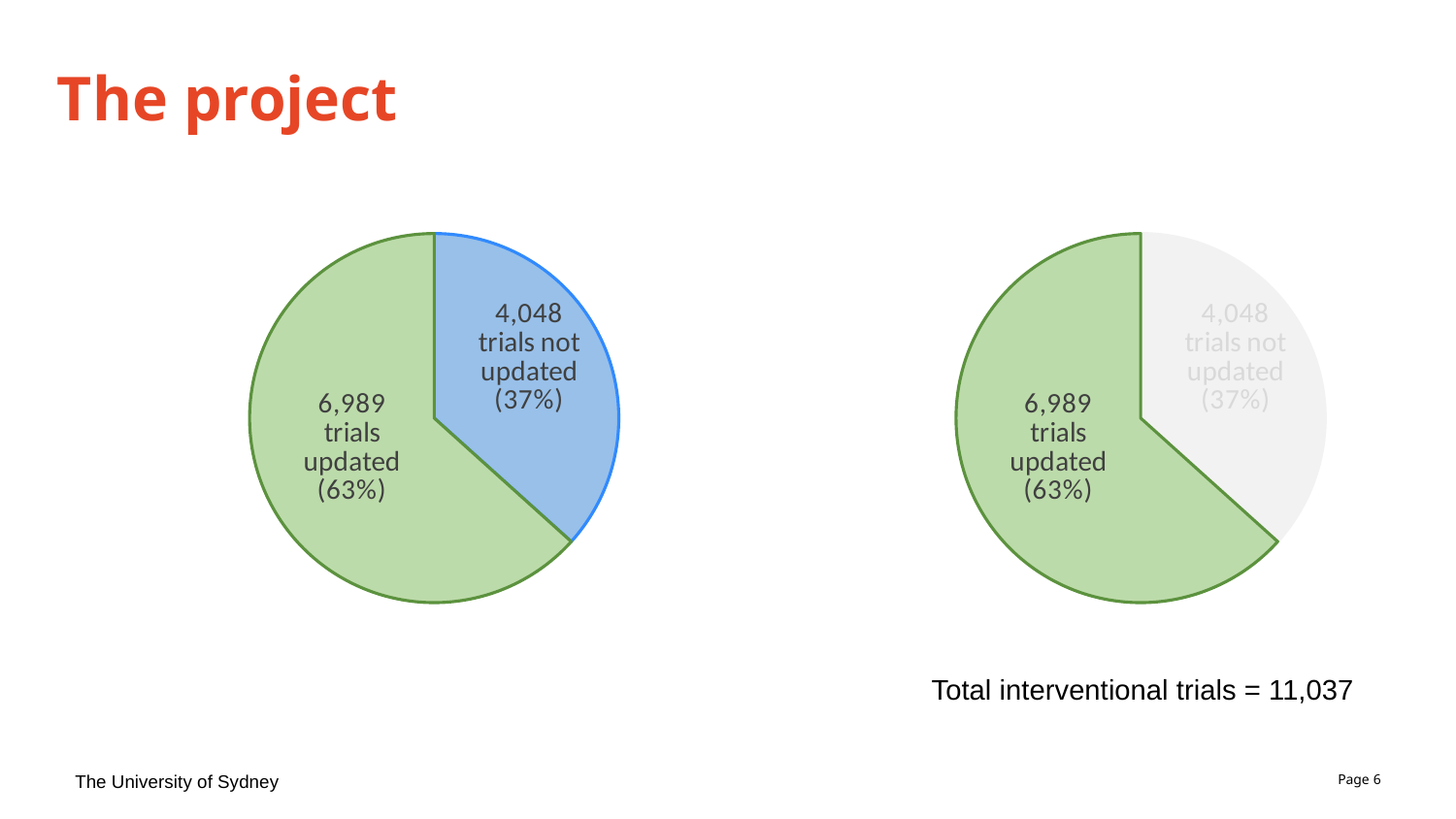
What kind of chart is shown on the left of the slide? pie chart How many slices does the left pie chart have? 2 In the right pie chart, how many trials were updated? 6,989 In the right pie chart, which slice is the smallest? trials not updated In the left pie chart, which slice is larger: trials updated or trials not updated? trials updated In the left pie chart, what colour is the 'trials not updated' slice? blue In the left pie chart, how many trials were not updated? 4,048 In the left pie chart, how many trials were updated? 6,989 In the left pie chart, what is the difference between the number of trials updated and the number of trials not updated? 2,941 In the left pie chart, what share of trials were updated? 63% In the left pie chart, what is the total number of trials across both slices? 11,037 In the left pie chart, what share of trials were not updated? 37%